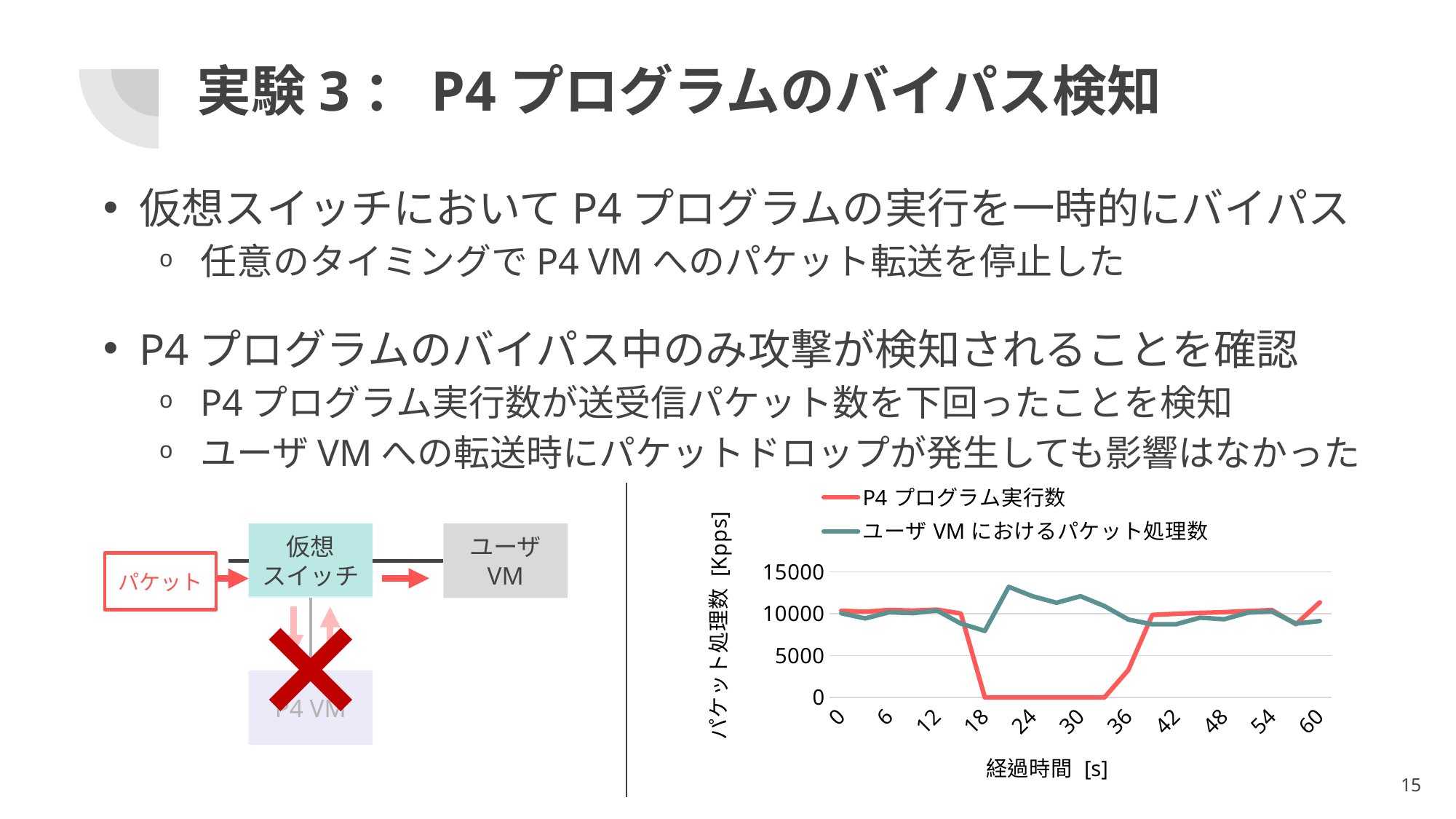
How many tick labels are shown on the x axis of the chart? 11 Does the P4 プログラム実行数 series rise or fall between 36 s and 42 s? rise Does the P4 プログラム実行数 series rise or fall between 12 s and 24 s? fall What are the two series named in the chart legend? P4 プログラム実行数, ユーザ VM におけるパケット処理数 What kind of chart is shown on the slide? line chart How many series does the chart legend list? 2 Is the value of P4 プログラム実行数 at 30 s greater or less than 5000? less Is the value of ユーザ VM におけるパケット処理数 at 42 s greater or less than 10000? less Is the value of ユーザ VM におけるパケット処理数 at 24 s greater or less than 10000? greater What is the x-axis title of the chart? 経過時間 [s] At 24 s, which series has the higher value, P4 プログラム実行数 or ユーザ VM におけるパケット処理数? ユーザ VM におけるパケット処理数